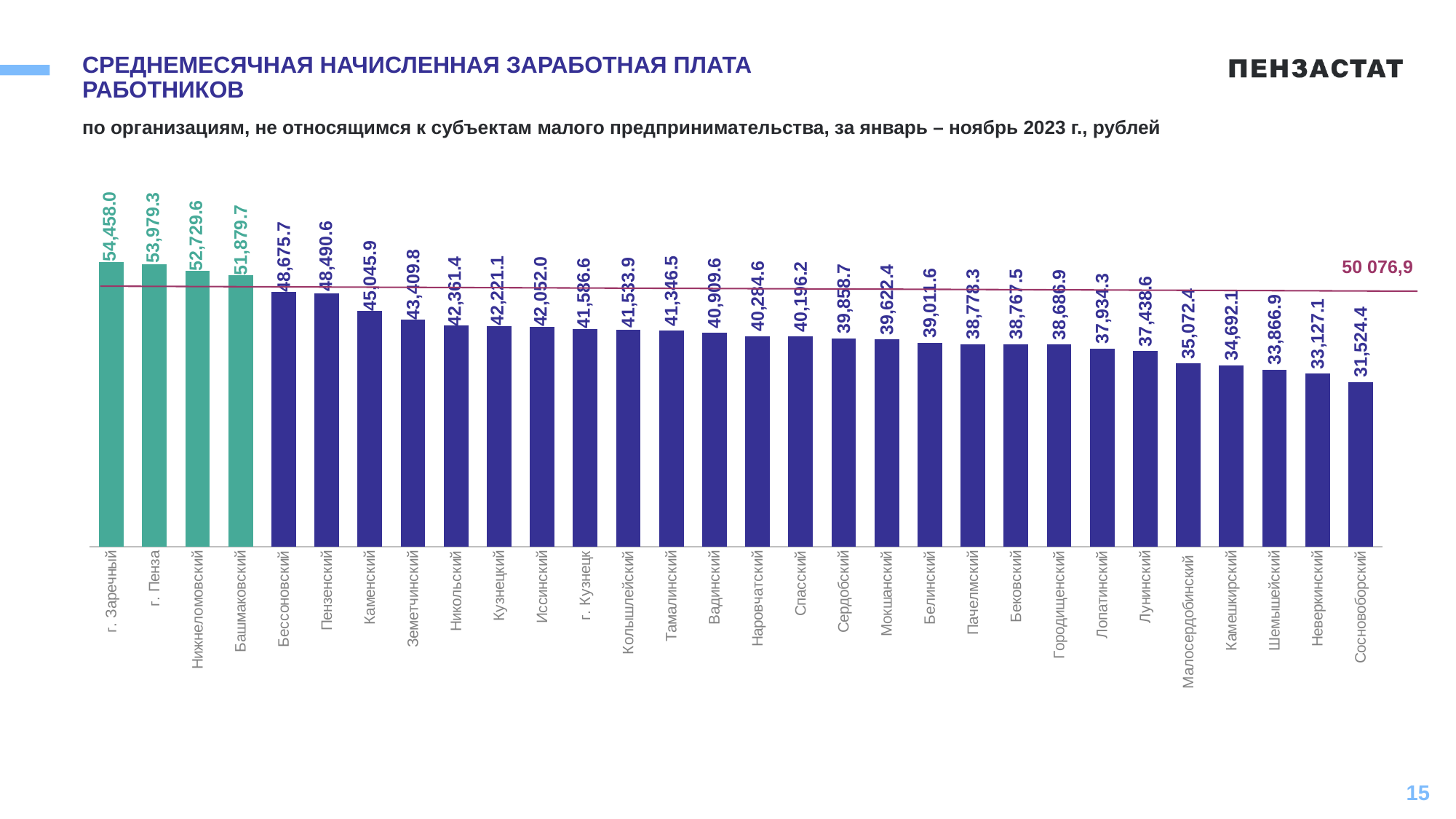
Which category has the highest value? г. Заречный What is the difference between the values for Бессоновский and Пензенский? 185.1 What is the value for Каменский? 45,045.9 How many categories are shown on the chart? 30 What value is shown for the horizontal reference line on the chart? 50 076,9 What kind of chart is this? bar chart What is the value for Сосновоборский? 31,524.4 Do the values rise or fall from left to right along the x axis? fall What is the difference between the values for г. Заречный and г. Пенза? 478.7 Which category has the lowest value? Сосновоборский Which is larger, the value for Лунинский or the value for Малосердобинский? Лунинский What is the value for г. Пенза? 53,979.3